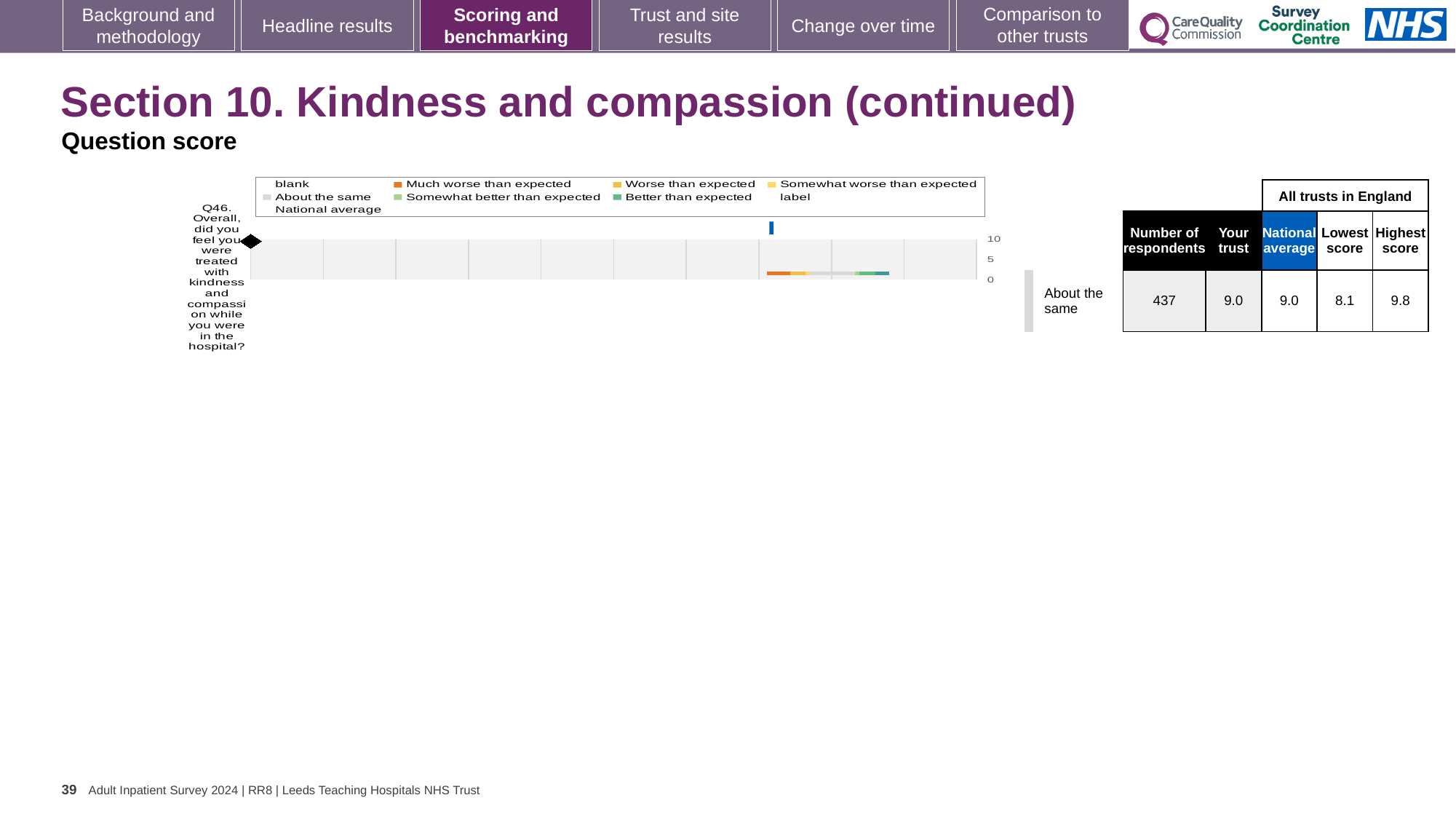
What colour in the legend represents "Much worse than expected"? orange What is the highest score among all trusts in England for Q46? 9.8 What is the highest tick value shown on the chart's score axis? 10 How many respondents answered Q46? 437 Which benchmark category is the trust's Q46 result placed in? About the same How many questions are plotted on the chart? 1 What kind of chart is used to show the Q46 question score? bar chart What is the "Your trust" score for Q46? 9.0 What is the difference between the highest score and the lowest score for Q46? 1.7 Which is larger for Q46: the highest score in England or the trust's own score? Highest score What is the national average score for Q46? 9.0 What is the lowest score among all trusts in England for Q46? 8.1